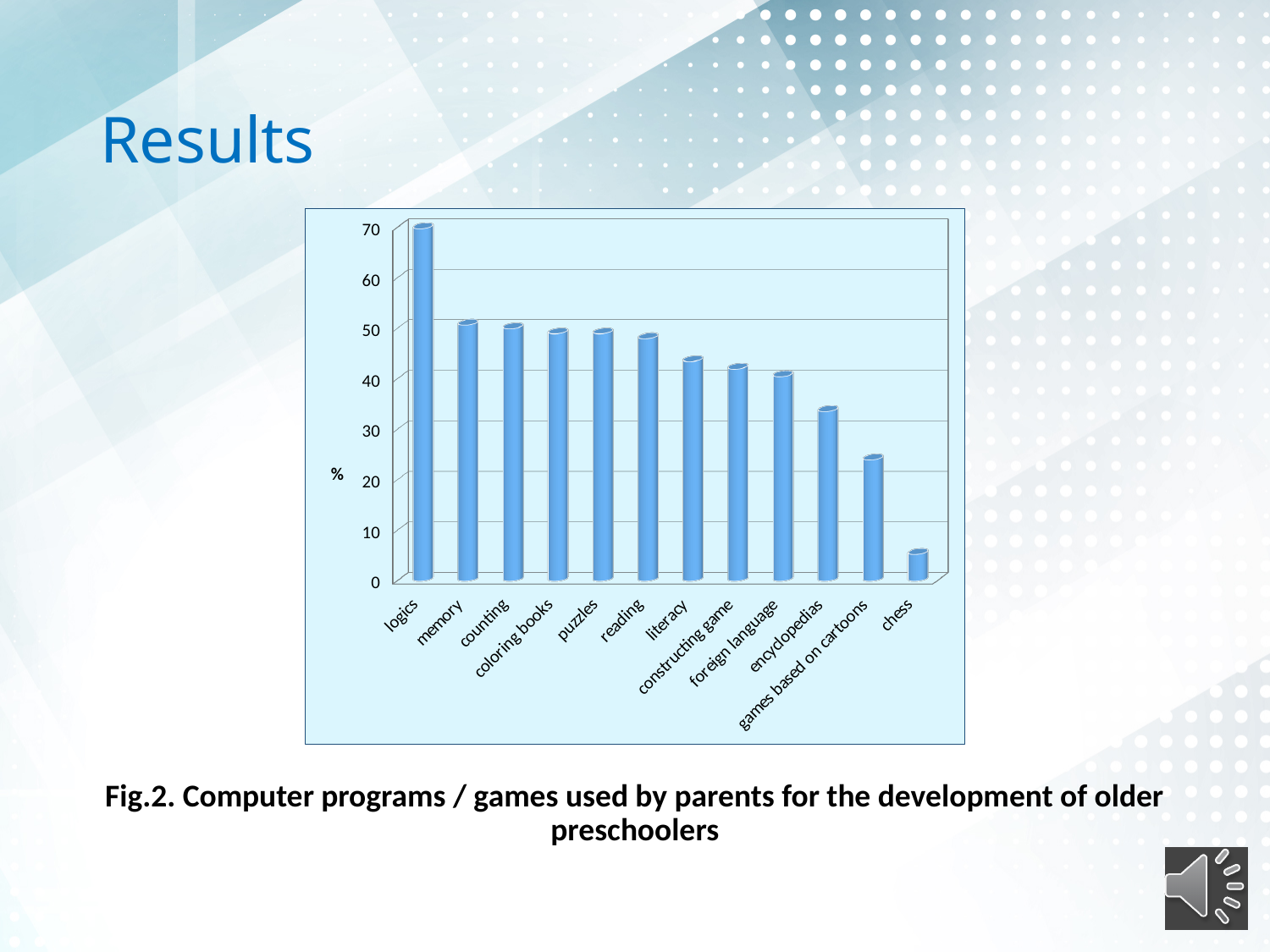
Is the value for games based on cartoons greater or less than 30? less Is the value for literacy greater or less than 40? greater How many categories are shown on the x axis of the chart? 12 What kind of chart is shown on the slide? bar chart Do the values rise or fall moving from left to right along the x axis? fall Which category has the highest value in the chart? logics Which category has the lowest value in the chart? chess Is the value for chess greater or less than 10? less What label is shown on the vertical axis of the chart? % Which is larger, the value for encyclopedias or the value for games based on cartoons? encyclopedias